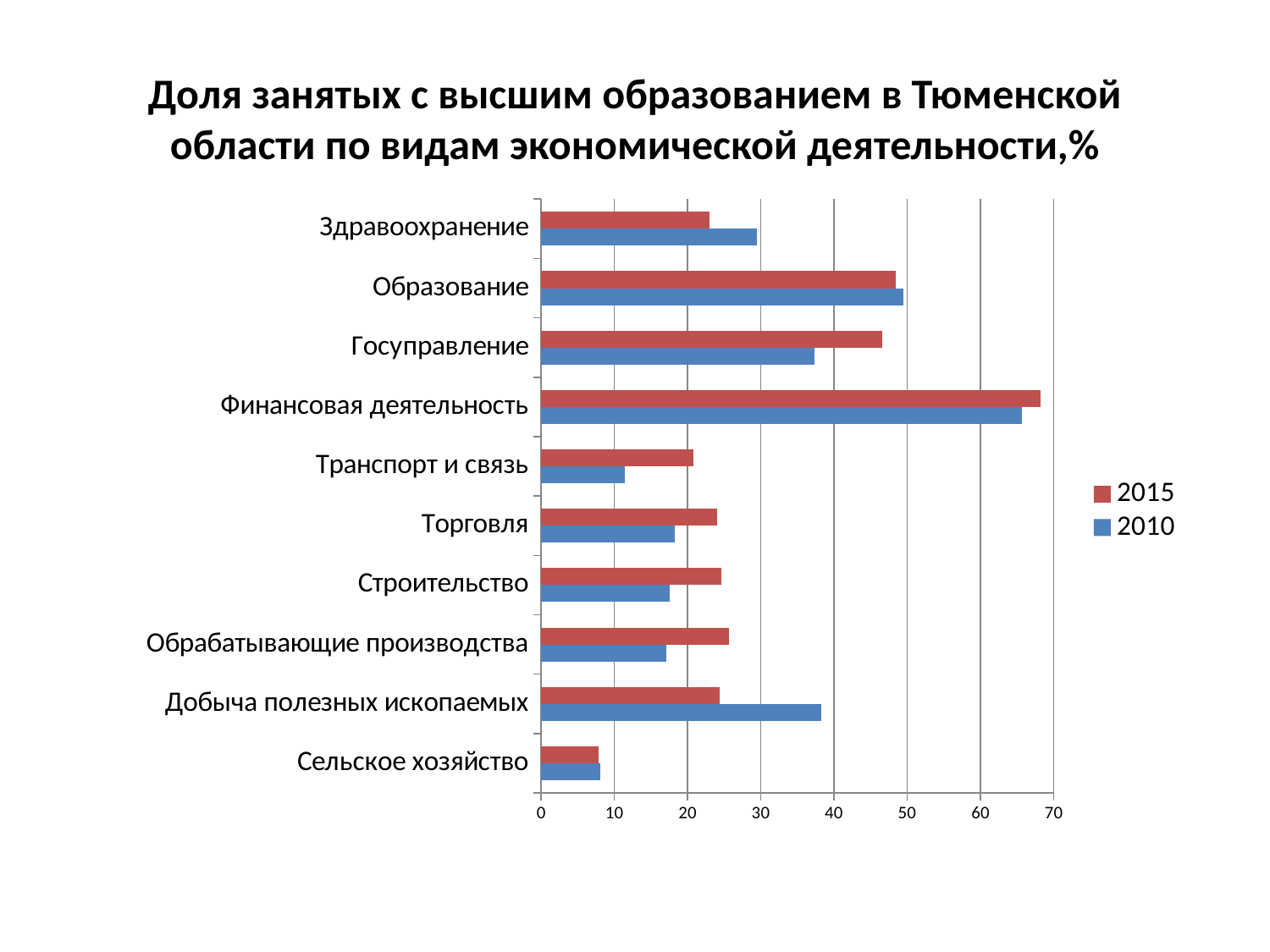
Which series is shown in red in the legend? 2015 Which category has the highest value for 2015? Финансовая деятельность Which category has the lowest value for 2010? Сельское хозяйство How many series does the legend list? 2 For Добыча полезных ископаемых, which year has the larger value, 2015 or 2010? 2010 Is the 2015 value for Финансовая деятельность greater or less than 60? greater What kind of chart is shown on the slide? bar chart What is the title of the chart? Доля занятых с высшим образованием в Тюменской области по видам экономической деятельности,% Is the 2010 value for Добыча полезных ископаемых greater or less than 30? greater How many categories (types of economic activity) are shown on the chart? 10 Is the 2010 value for Транспорт и связь greater or less than 20? less For Госуправление, which year has the larger value, 2015 or 2010? 2015